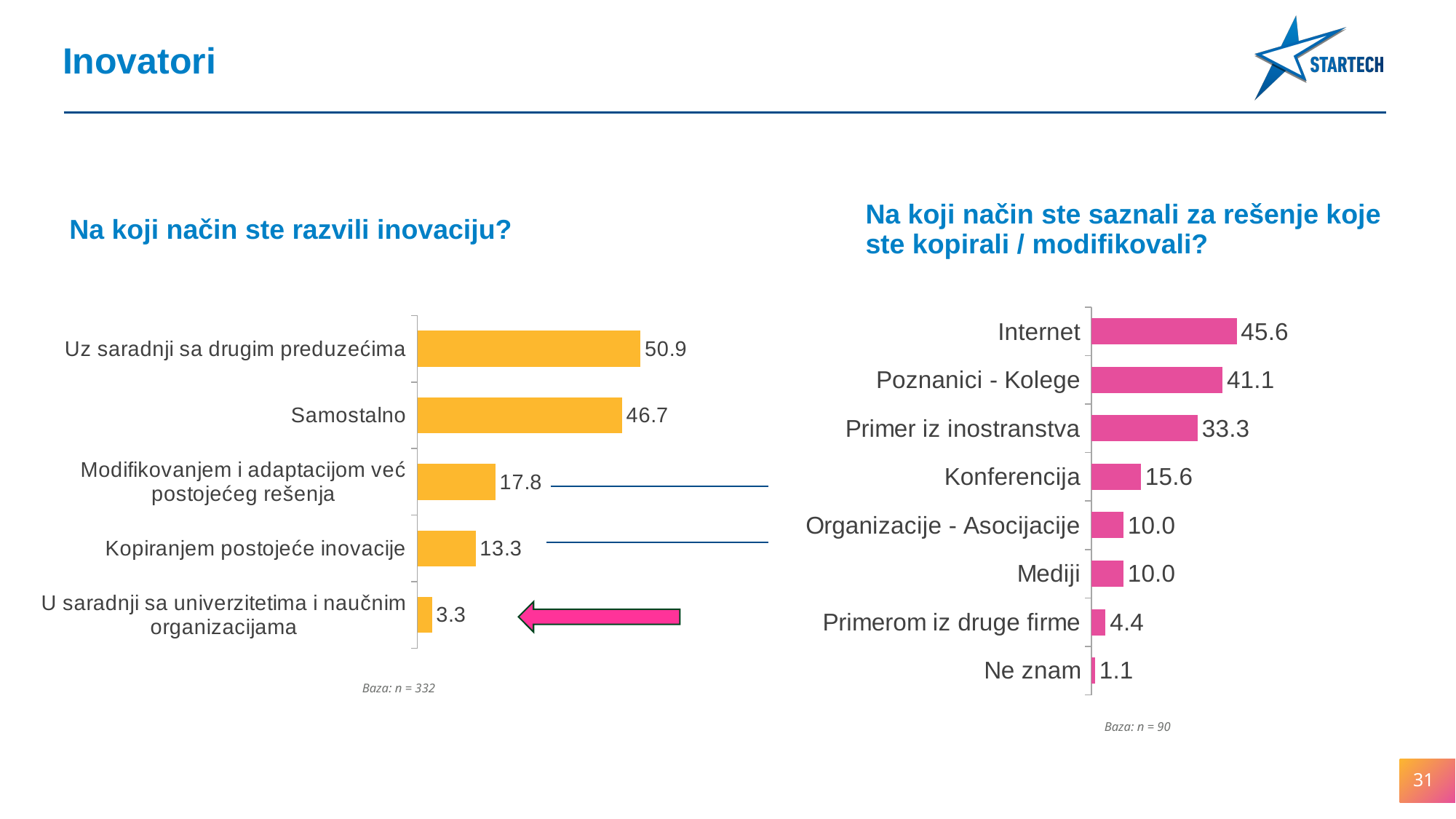
In the left chart 'Na koji način ste razvili inovaciju?', which category has the lowest value? U saradnji sa univerzitetima i naučnim organizacijama In the left chart 'Na koji način ste razvili inovaciju?', what is the value for 'Samostalno'? 46.7 In the right chart 'Na koji način ste saznali za rešenje koje ste kopirali / modifikovali?', which is larger: 'Primer iz inostranstva' or 'Konferencija'? Primer iz inostranstva In the right chart 'Na koji način ste saznali za rešenje koje ste kopirali / modifikovali?', what is the value for 'Konferencija'? 15.6 In the right chart 'Na koji način ste saznali za rešenje koje ste kopirali / modifikovali?', what is the difference between 'Internet' and 'Poznanici - Kolege'? 4.5 What kind of chart is the right chart 'Na koji način ste saznali za rešenje koje ste kopirali / modifikovali?'? Bar chart In the right chart 'Na koji način ste saznali za rešenje koje ste kopirali / modifikovali?', how many categories are shown? 8 In the right chart 'Na koji način ste saznali za rešenje koje ste kopirali / modifikovali?', which category has the lowest value? Ne znam In the left chart 'Na koji način ste razvili inovaciju?', what is the difference between 'Modifikovanjem i adaptacijom već postojećeg rešenja' and 'Kopiranjem postojeće inovacije'? 4.5 In the left chart 'Na koji način ste razvili inovaciju?', how many categories are shown? 5 In the right chart 'Na koji način ste saznali za rešenje koje ste kopirali / modifikovali?', which category has the highest value? Internet In the left chart 'Na koji način ste razvili inovaciju?', which category has the highest value? Uz saradnji sa drugim preduzećima